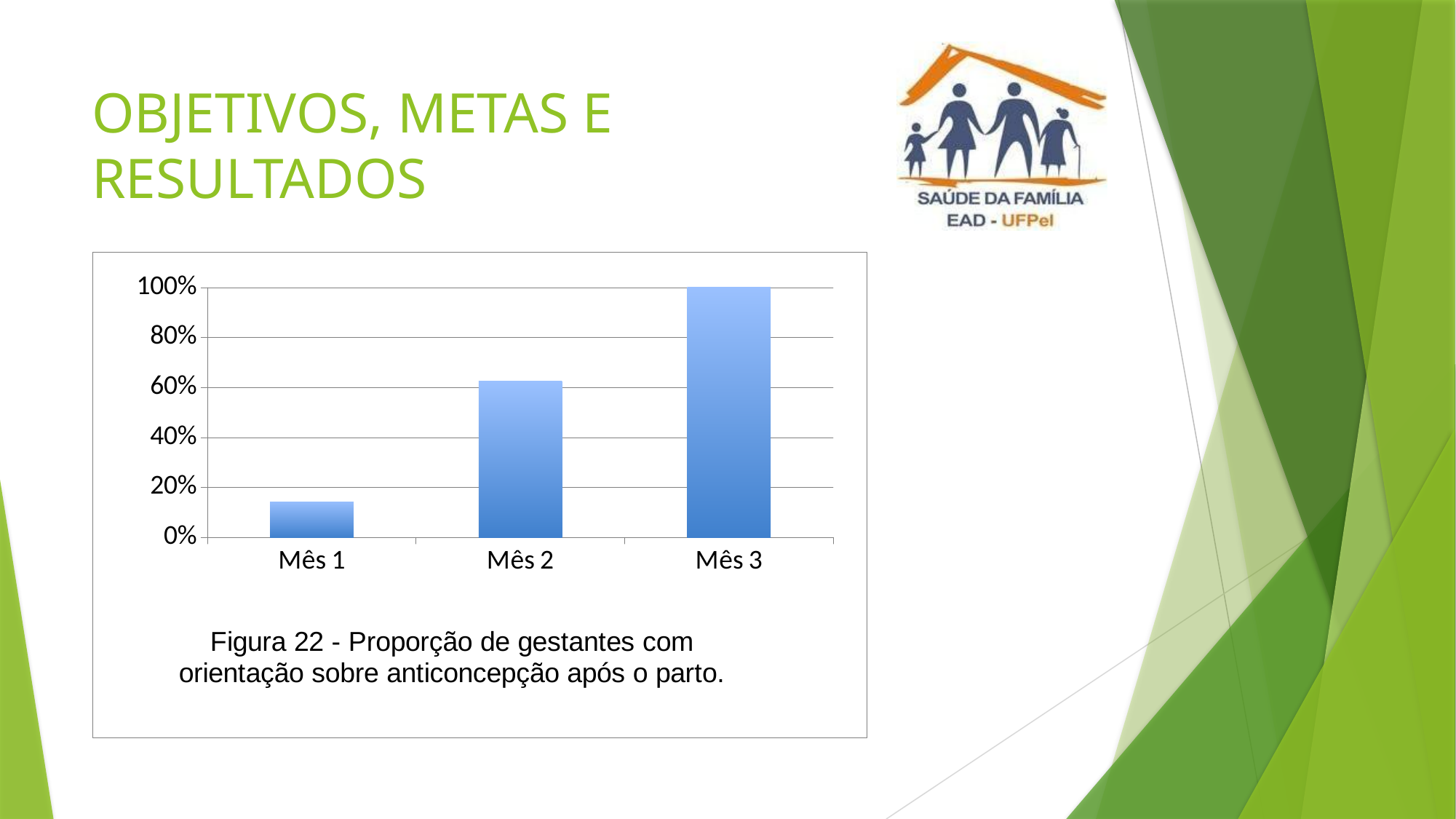
Which month has the highest value in the chart? Mês 3 Which is larger, the value for Mês 1 or the value for Mês 2? Mês 2 What kind of chart is shown on the slide? bar chart Is the value for Mês 2 greater or less than 40%? greater How many categories are plotted on the x axis of the chart? 3 Do the values rise or fall from Mês 1 to Mês 3? rise Is the value for Mês 1 greater or less than 20%? less What is the value for Mês 3? 100% What is the highest value shown on the y axis of the chart? 100% What is the figure number given in the caption below the chart? Figura 22 Which month has the lowest value in the chart? Mês 1 Is the value for Mês 2 greater or less than 80%? less